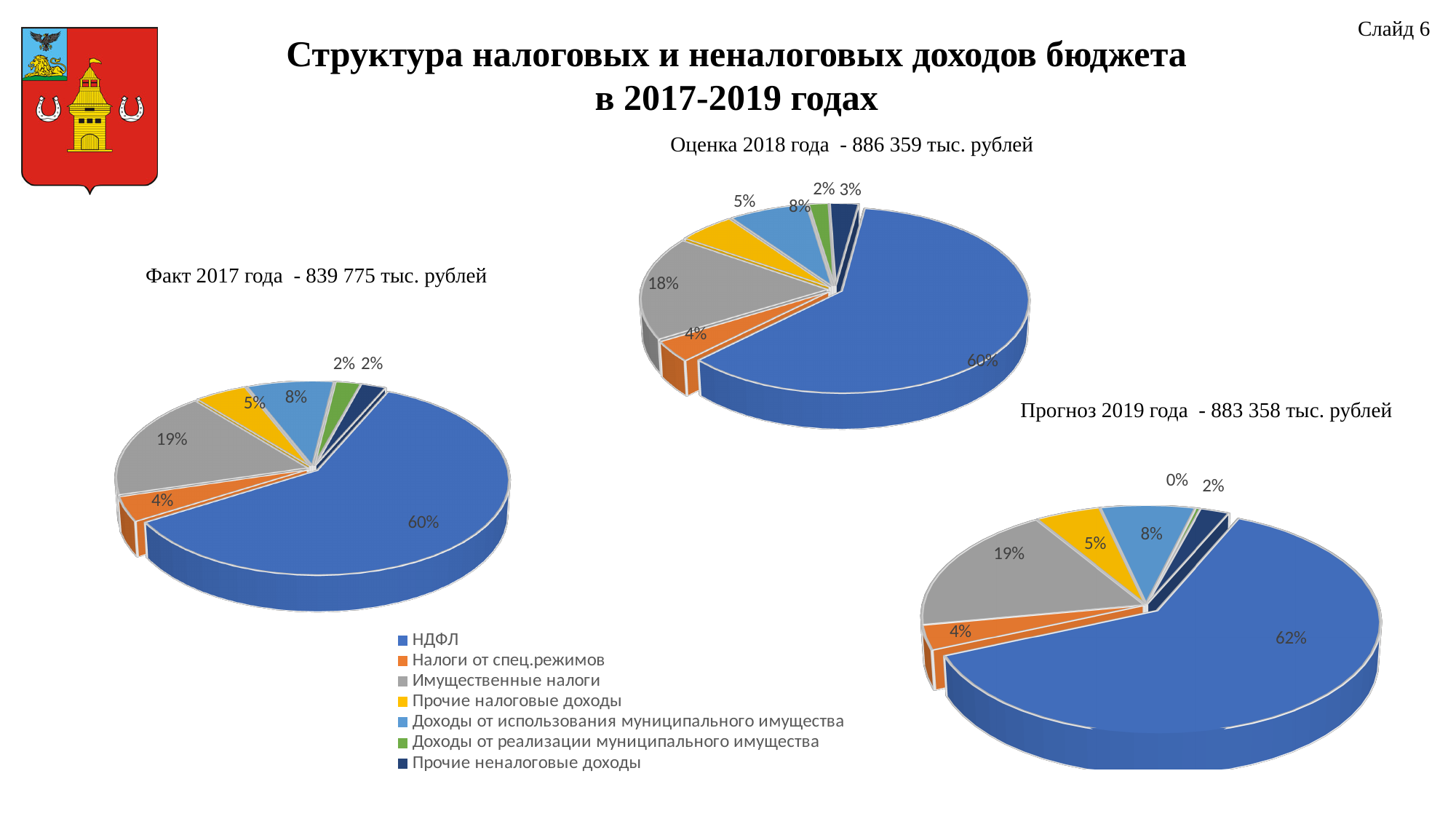
In the 'Оценка 2018 года' pie chart, what is the difference between the share of НДФЛ and the share of Имущественные налоги? 42% What kind of charts are shown on the slide? Pie charts In the 'Прогноз 2019 года' pie chart, what share does НДФЛ have? 62% In the 'Факт 2017 года' pie chart, what share does НДФЛ have? 60% What total amount is stated for 'Оценка 2018 года'? 886 359 тыс. рублей In the 'Факт 2017 года' pie chart, which is larger: the share of Прочие налоговые доходы or the share of Доходы от использования муниципального имущества? Доходы от использования муниципального имущества How many series does the shared legend list? 7 In the 'Оценка 2018 года' pie chart, what share do Имущественные налоги have? 18% In the 'Факт 2017 года' pie chart, which category has the largest share? НДФЛ What colour represents НДФЛ in the legend? Blue In the 'Прогноз 2019 года' pie chart, which category has the smallest share? Доходы от реализации муниципального имущества